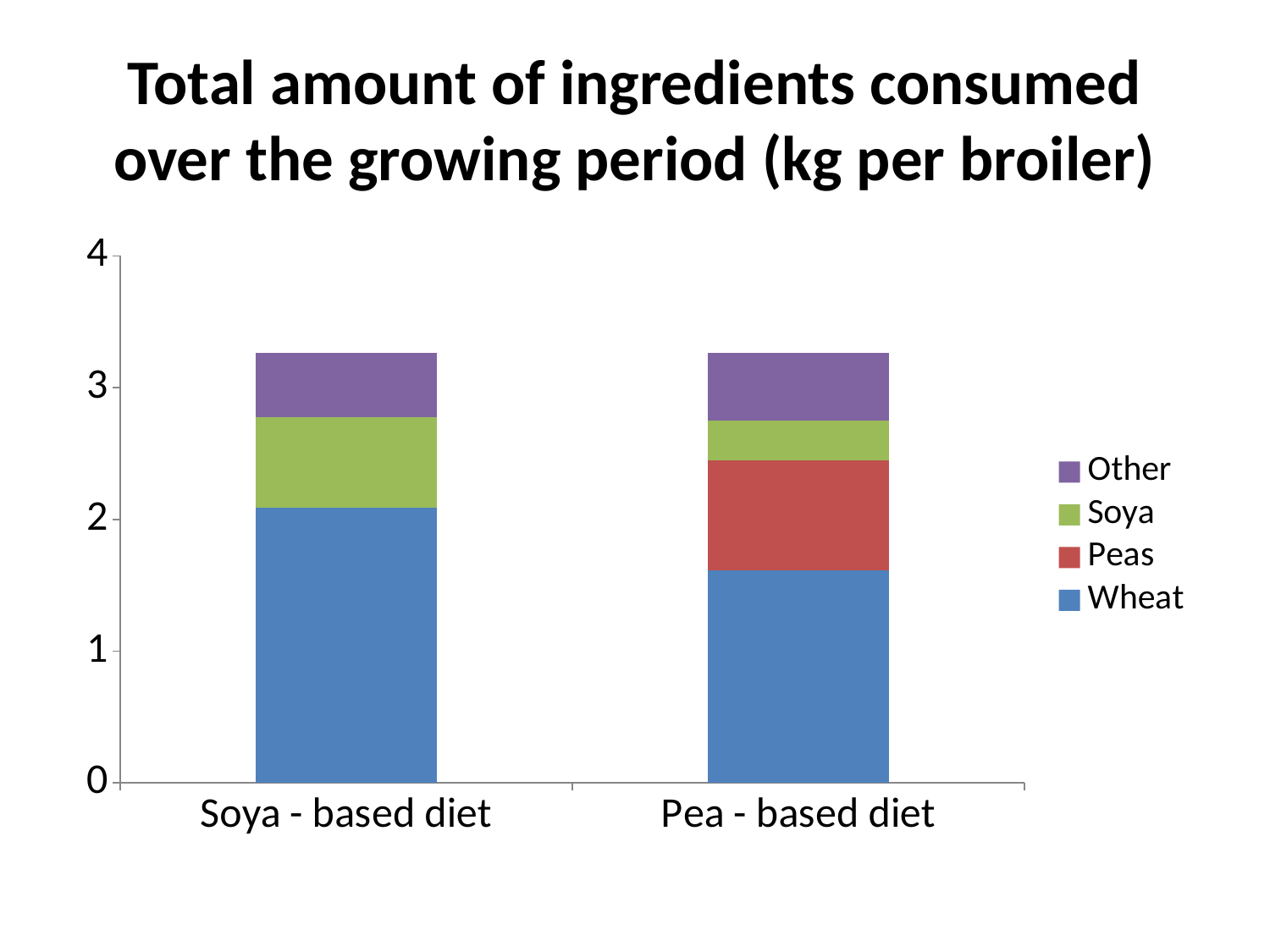
Which diet has the larger Wheat segment, Soya - based diet or Pea - based diet? Soya - based diet Which colour represents Wheat in the chart? Blue Which ingredient is the largest segment in the Pea - based diet bar? Wheat How many diet categories are shown on the x axis? 2 Is the Wheat value for the Pea - based diet greater or less than 2? less Which ingredient series appears only in the Pea - based diet bar? Peas Which diet has the larger Soya segment, Soya - based diet or Pea - based diet? Soya - based diet Is the Wheat value for the Soya - based diet greater or less than 3? less Is the total height of the Soya - based diet bar greater or less than 3? greater What kind of chart is shown on the slide? Stacked bar chart How many series does the legend list? 4